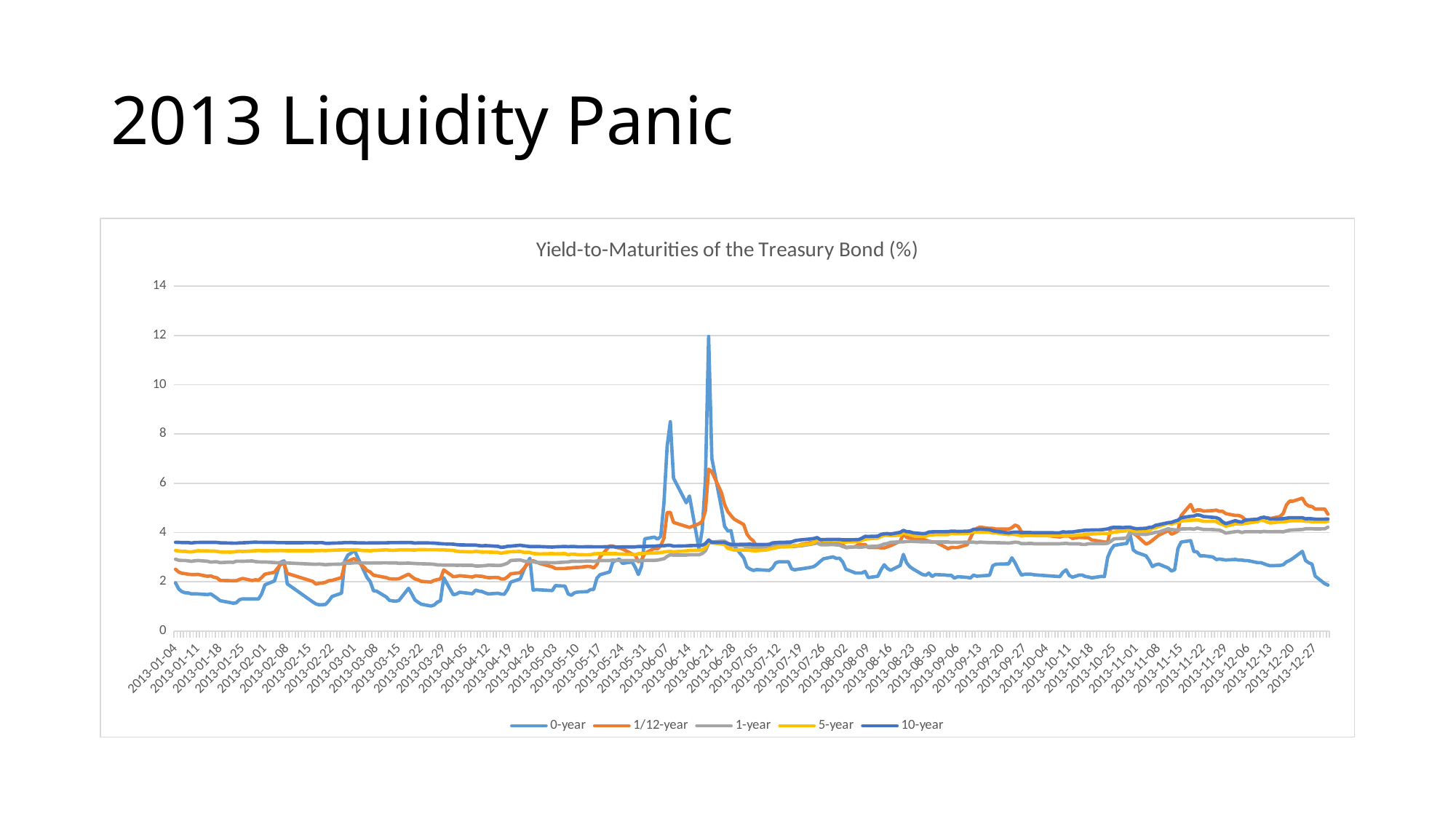
Does the 10-year series generally rise or fall from the start to the end of 2013? rise At 2013-01-04, which is larger, the 10-year series or the 0-year series? 10-year Is the value of the 1/12-year series at 2013-01-04 greater or less than 4? less Which series reaches the highest value on the chart? 0-year Is the value of the 10-year series at 2013-01-04 greater or less than 4? less Is the peak value of the 1/12-year series greater or less than 8? less How many series does the legend list? 5 Which series are listed in the legend? 0-year, 1/12-year, 1-year, 5-year, 10-year What kind of chart is shown on the slide? line chart How many date labels are shown on the x axis? 52 What is the title of the chart? Yield-to-Maturities of the Treasury Bond (%)